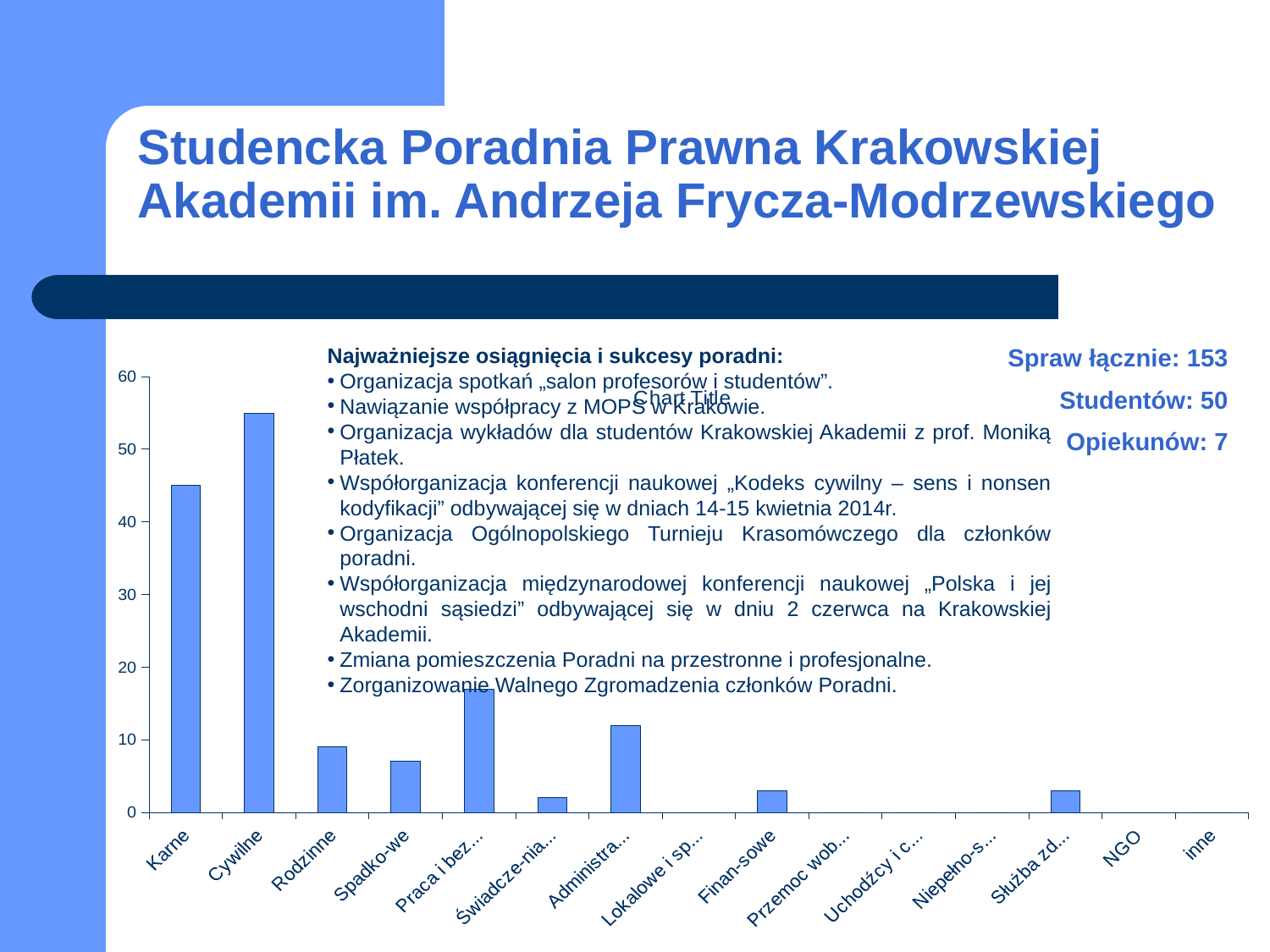
Which is larger, the value for Rodzinne or the value for Spadko-we? Rodzinne Is the value for Cywilne greater or less than 50? greater Which category has the highest bar in the chart? Cywilne Is the value for Karne greater or less than 40? greater What kind of chart is shown on the slide? bar chart What is the title shown above the chart? Chart Title Which is larger, the value for Karne or the value for Cywilne? Cywilne Is the value for Praca i bez... greater or less than 10? greater Which is larger, the value for Praca i bez... or the value for Administra...? Praca i bez... How many categories are shown on the x axis of the chart? 15